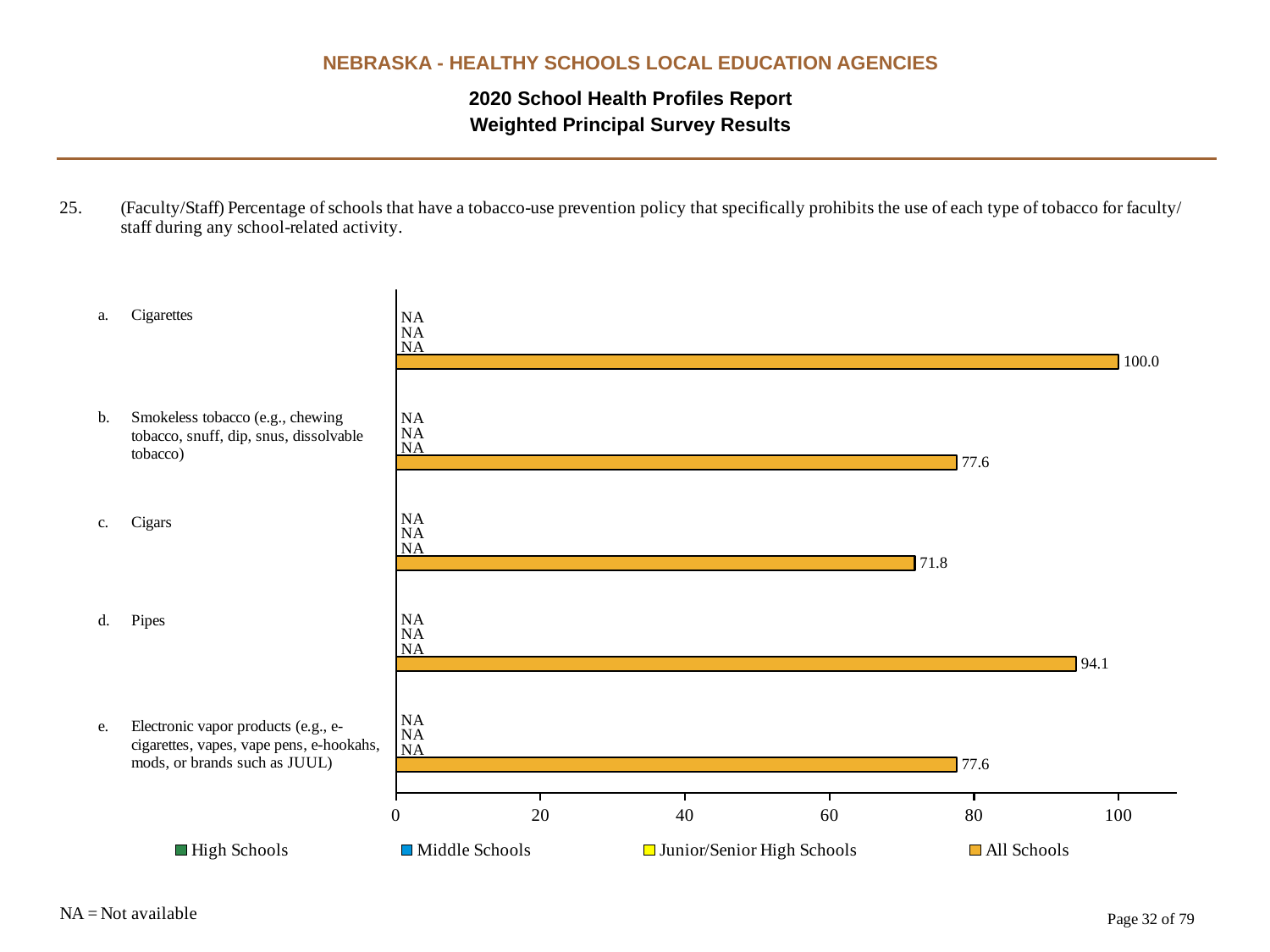
What is the All Schools value for Cigarettes? 100.0 Which category has the highest All Schools value? Cigarettes Which category has the lowest All Schools value? Cigars What is the difference between the All Schools values for Cigarettes and Pipes? 5.9 What is the All Schools value for Electronic vapor products? 77.6 What kind of chart is shown on the slide? bar chart Is the All Schools value for Cigars greater or less than 80? less What is the All Schools value for Cigars? 71.8 How many series does the legend list? 4 What is the All Schools value for Pipes? 94.1 How many tobacco categories are shown in the chart? 5 Which has a larger All Schools value, Pipes or Smokeless tobacco? Pipes